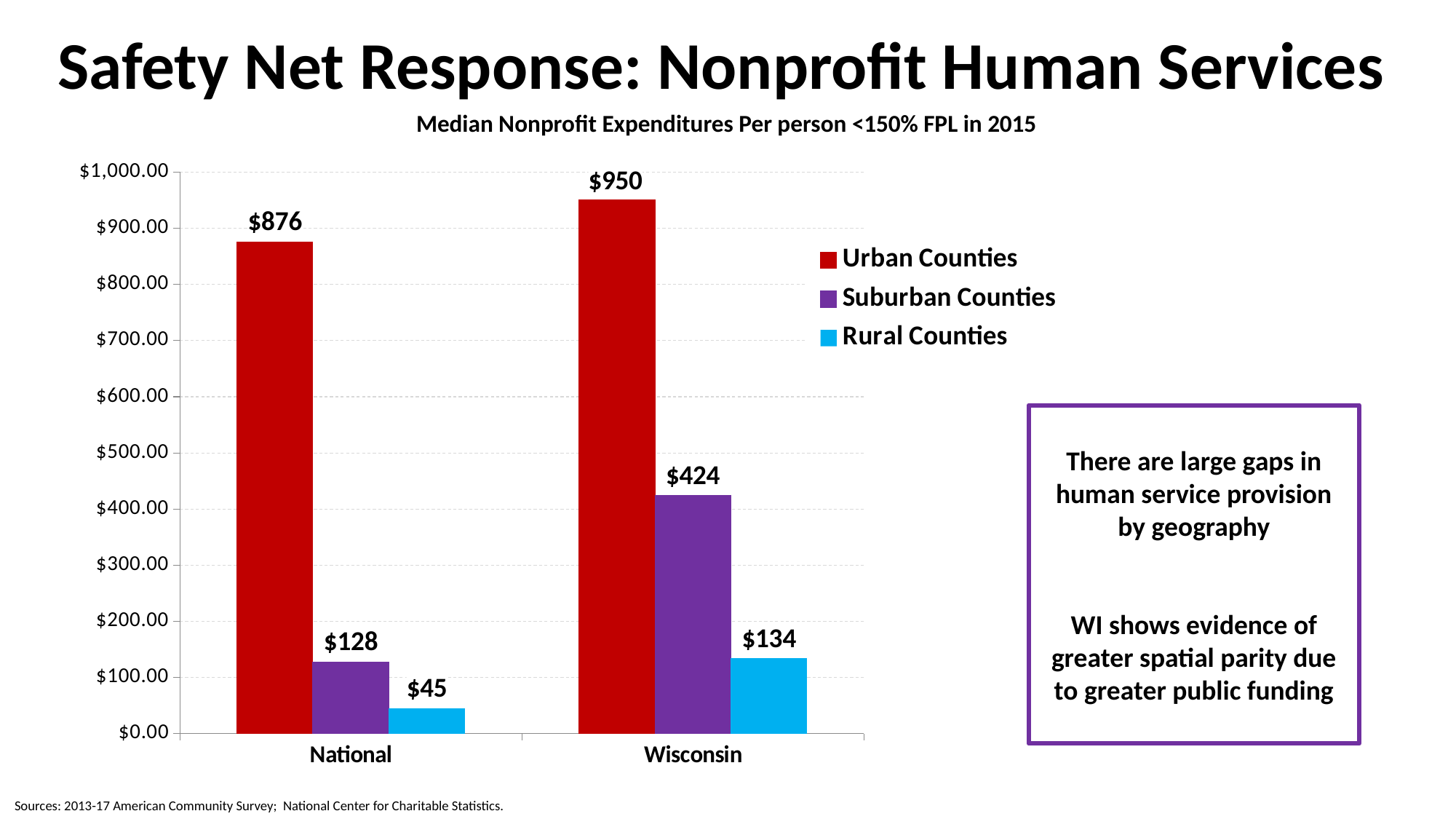
What kind of chart is shown on the slide? Bar chart What is the difference between the Urban Counties values for Wisconsin and National? $74 How many series does the legend list? 3 Which is larger: Rural Counties in Wisconsin or Suburban Counties in National? Rural Counties in Wisconsin What is the median nonprofit expenditure per person for Urban Counties in Wisconsin? $950 What is the value for Rural Counties in the National group? $45 What is the value for Suburban Counties in Wisconsin? $424 How many categories are shown on the x axis? 2 What colour represents Rural Counties in the chart? Light blue What is the difference between Suburban Counties and Rural Counties in the National group? $83 Which series has the lowest value in the Wisconsin group? Rural Counties Which series has the highest value in the National group? Urban Counties